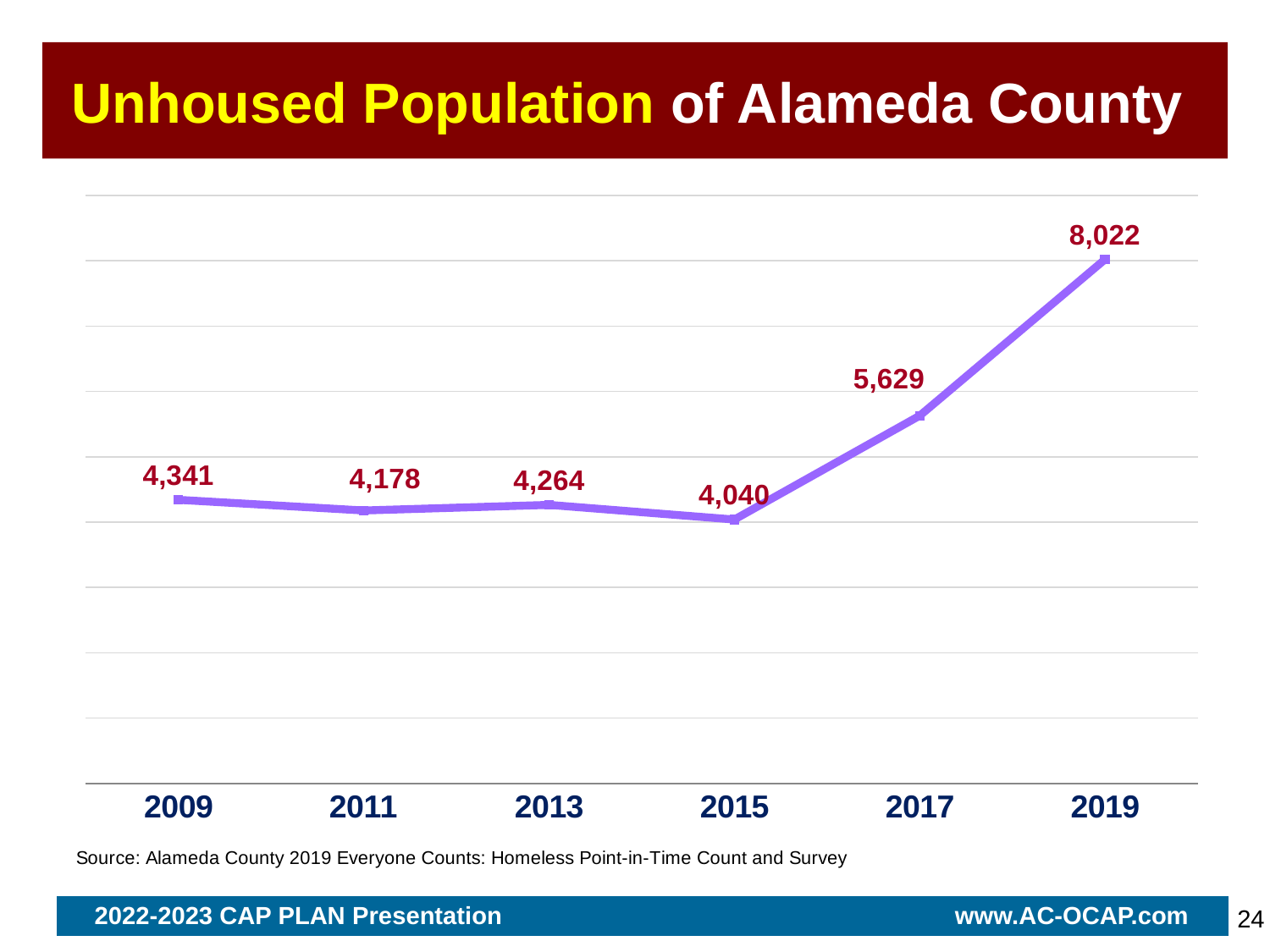
What is the difference between the unhoused population in 2009 and in 2015? 301 What was the unhoused population of Alameda County in 2009? 4,341 What kind of chart is shown on the slide? Line chart What was the unhoused population of Alameda County in 2019? 8,022 What is the difference between the unhoused population in 2019 and in 2017? 2,393 How many years are plotted on the chart? 6 Does the unhoused population rise or fall between 2015 and 2019? Rise Which year shows the lowest unhoused population? 2015 What is the title of the chart on the slide? Unhoused Population of Alameda County Which year had a larger unhoused population, 2013 or 2011? 2013 What was the unhoused population of Alameda County in 2015? 4,040 Which year shows the highest unhoused population? 2019